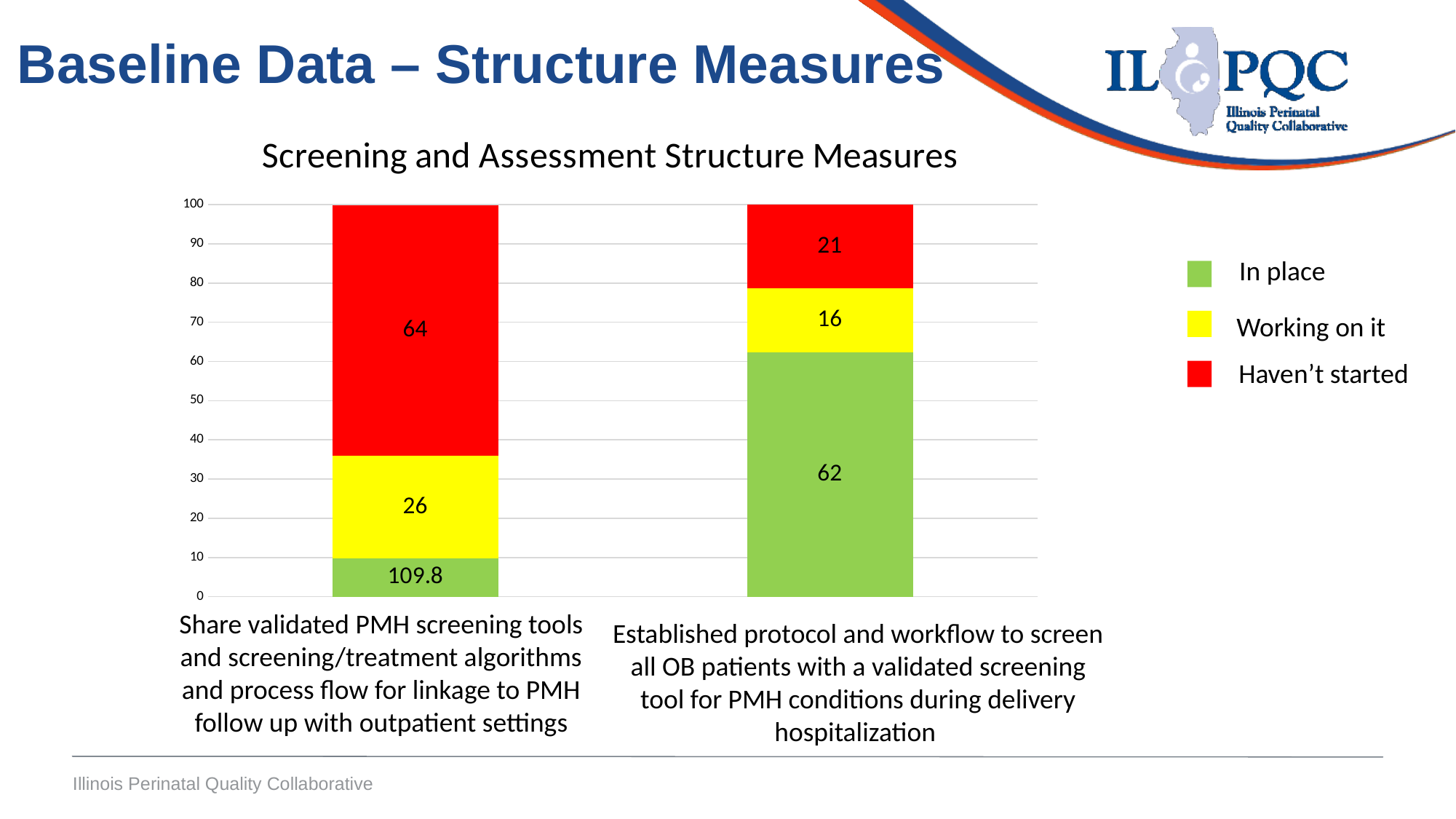
What is the difference between the 'Haven't started' values of the two categories? 43 What kind of chart is shown on the slide? bar chart What is the 'Haven't started' value for 'Established protocol and workflow to screen all OB patients with a validated screening tool for PMH conditions during delivery hospitalization'? 21 What is the 'Working on it' value for 'Established protocol and workflow to screen all OB patients with a validated screening tool for PMH conditions during delivery hospitalization'? 16 What is the 'In place' value for 'Established protocol and workflow to screen all OB patients with a validated screening tool for PMH conditions during delivery hospitalization'? 62 Is the 'In place' value for 'Share validated PMH screening tools and screening/treatment algorithms and process flow for linkage to PMH follow up with outpatient settings' greater or less than 20? less How many series does the legend list? 3 Which category has the larger 'Haven't started' value? Share validated PMH screening tools and screening/treatment algorithms and process flow for linkage to PMH follow up with outpatient settings What is the 'Haven't started' value for 'Share validated PMH screening tools and screening/treatment algorithms and process flow for linkage to PMH follow up with outpatient settings'? 64 What is the title of the chart? Screening and Assessment Structure Measures How many categories (bars) are plotted in the chart? 2 What is the 'Working on it' value for 'Share validated PMH screening tools and screening/treatment algorithms and process flow for linkage to PMH follow up with outpatient settings'? 26